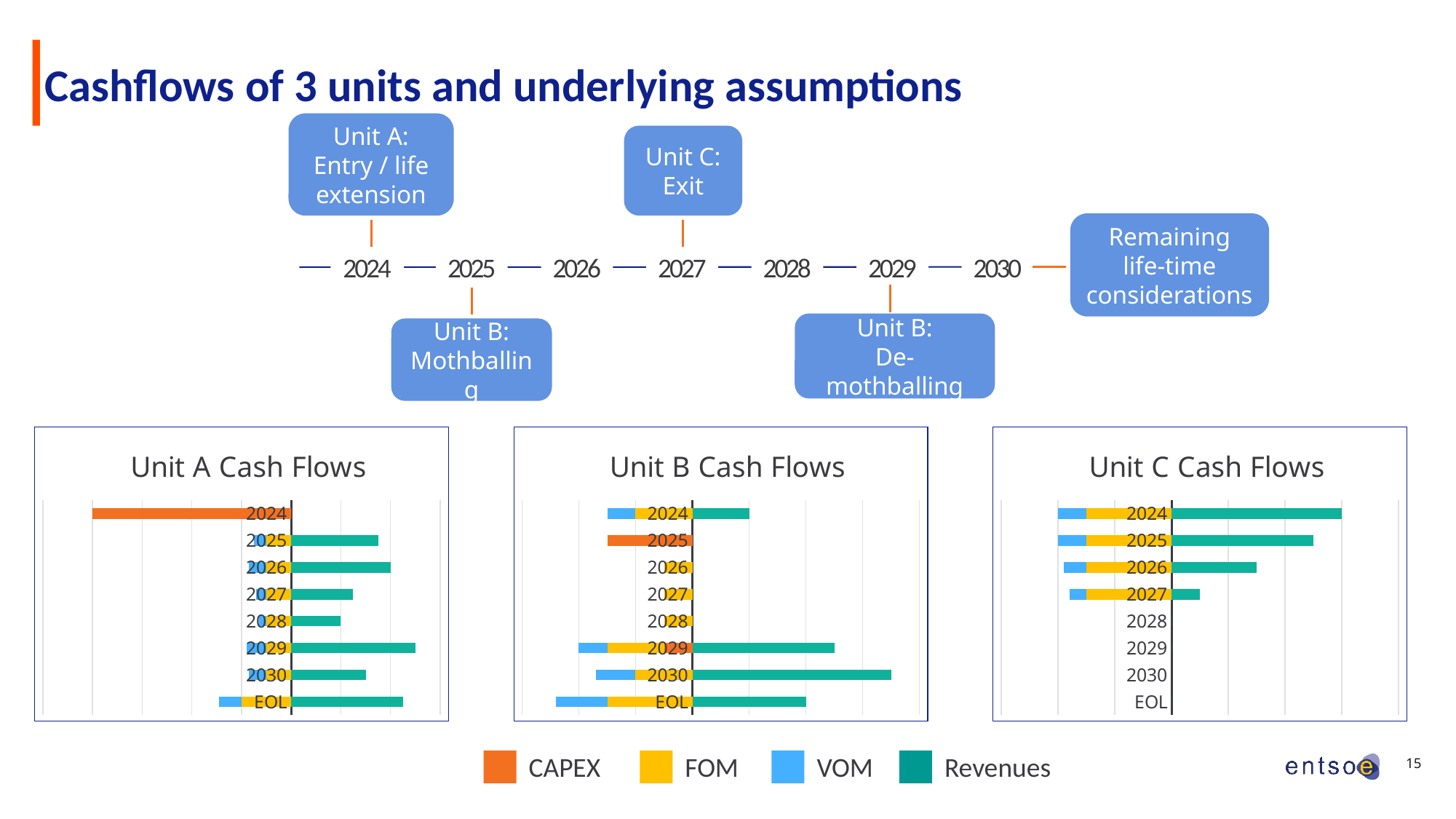
In the Unit A Cash Flows chart, which has larger Revenues, 2028 or 2029? 2029 In the Unit B Cash Flows chart, which category has the highest Revenues? 2030 How many series does the shared legend below the charts list? 4 In the Unit C Cash Flows chart, which year has the lowest non-zero Revenues? 2027 In the Unit C Cash Flows chart, which year has the highest Revenues? 2024 In the Unit C Cash Flows chart, do Revenues rise or fall from 2024 to 2027? Fall What kind of chart is the Unit A Cash Flows chart? Bar chart In the Unit C Cash Flows chart, how many categories have no bars at all? 4 In the Unit B Cash Flows chart, which year has a CAPEX bar? 2025 In the Unit A Cash Flows chart, which year has a CAPEX bar? 2024 In the Unit A Cash Flows chart, which year has the lowest Revenues? 2028 How many categories are shown on the vertical axis of the Unit A Cash Flows chart? 8